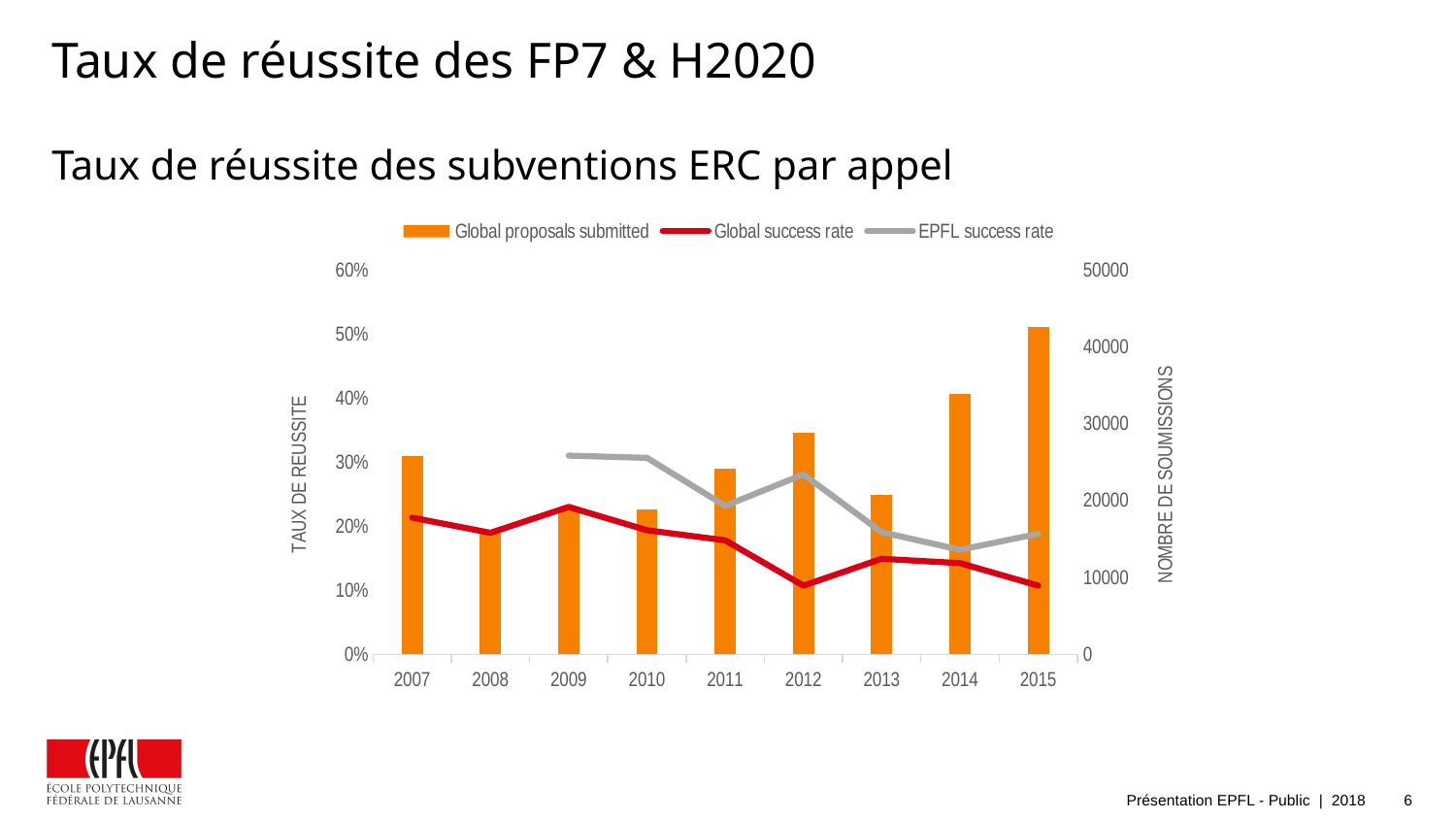
How many years are shown on the x axis? 9 In 2009, which is higher: the EPFL success rate or the Global success rate? EPFL success rate What kind of chart is shown on the slide? A combination bar and line chart In which year is the Global proposals submitted bar the highest? 2015 In which year is the EPFL success rate the lowest? 2014 Is the EPFL success rate in 2014 greater or less than 20%? less Does the Global success rate generally rise or fall from 2007 to 2015? fall In which year is the Global proposals submitted bar the lowest? 2008 Is the value for Global proposals submitted in 2015 greater or less than 40000? greater How many series does the legend list? 3 In which year is the Global success rate the highest? 2009 Is the value for Global proposals submitted in 2008 greater or less than 20000? less